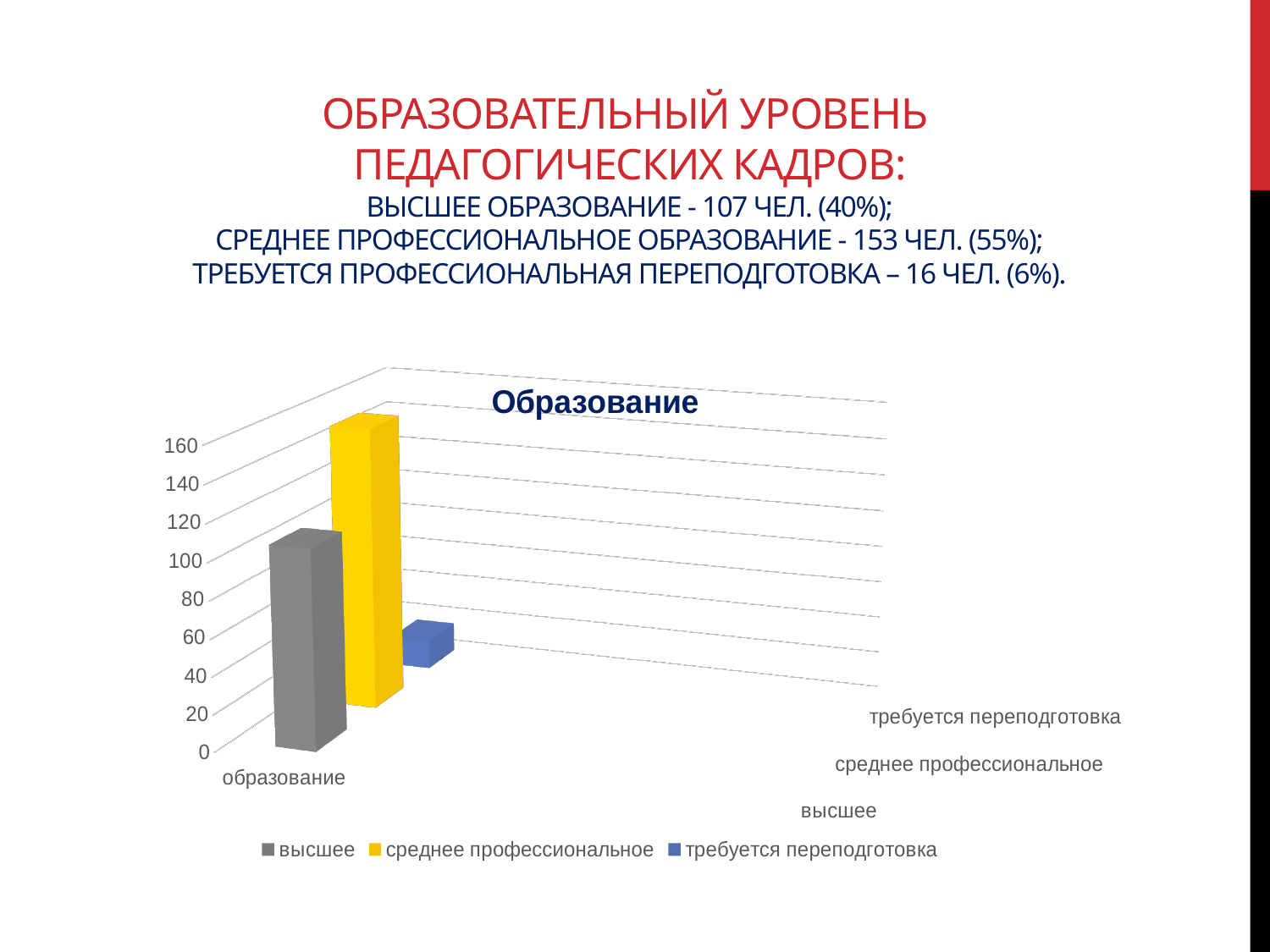
Which is larger, the bar for высшее or the bar for требуется переподготовка? высшее Is the value for среднее профессиональное greater or less than 140? greater How many series does the chart legend list? 3 Is the value for высшее greater or less than 100? greater According to the slide, how many people have secondary professional education (среднее профессиональное образование)? 153 What colour is the bar for среднее профессиональное? yellow According to the slide, how many people have higher education (высшее образование)? 107 Which series has the highest bar in the chart? среднее профессиональное Is the value for требуется переподготовка greater or less than 40? less Which series has the lowest bar in the chart? требуется переподготовка What is the title of the chart? Образование What type of chart is shown on the slide? bar chart